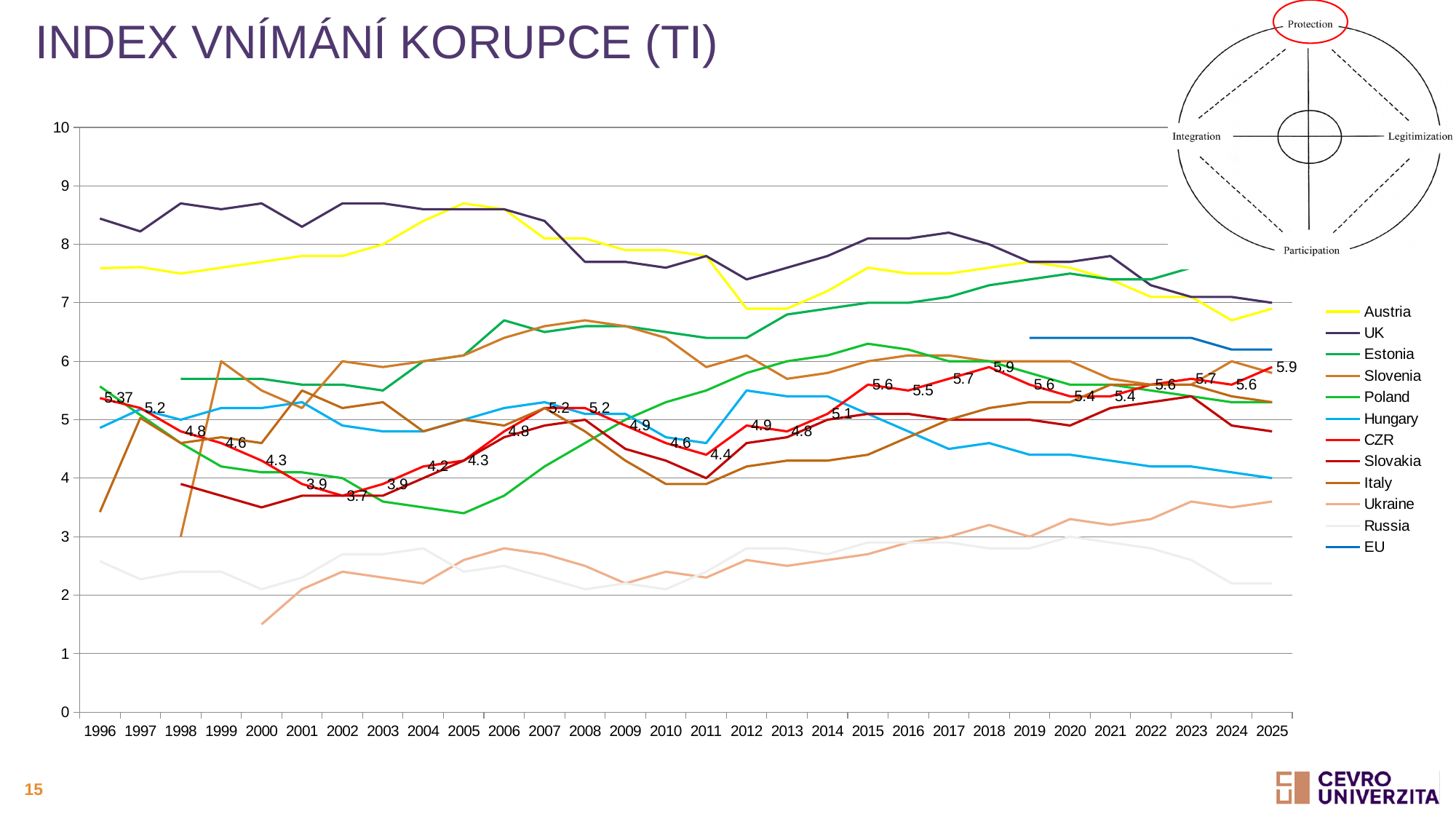
What is the labelled value for CZR in 2025? 5.9 What is the labelled value for CZR in 1996? 5.37 Is the value for UK in 1996 greater or less than 8? greater Which series has the lowest value in 2025? Russia In which year does the CZR line reach its lowest labelled value? 2002 How many years are shown on the x axis? 30 Is the value for Ukraine in 2000 greater or less than 2? less How many series does the legend list? 12 What kind of chart is shown on the slide? line chart What is the difference between the CZR values in 2018 and 2011? 1.5 Does the Hungary line rise or fall from 2012 to 2025? fall What is the labelled value for CZR in 2002? 3.7